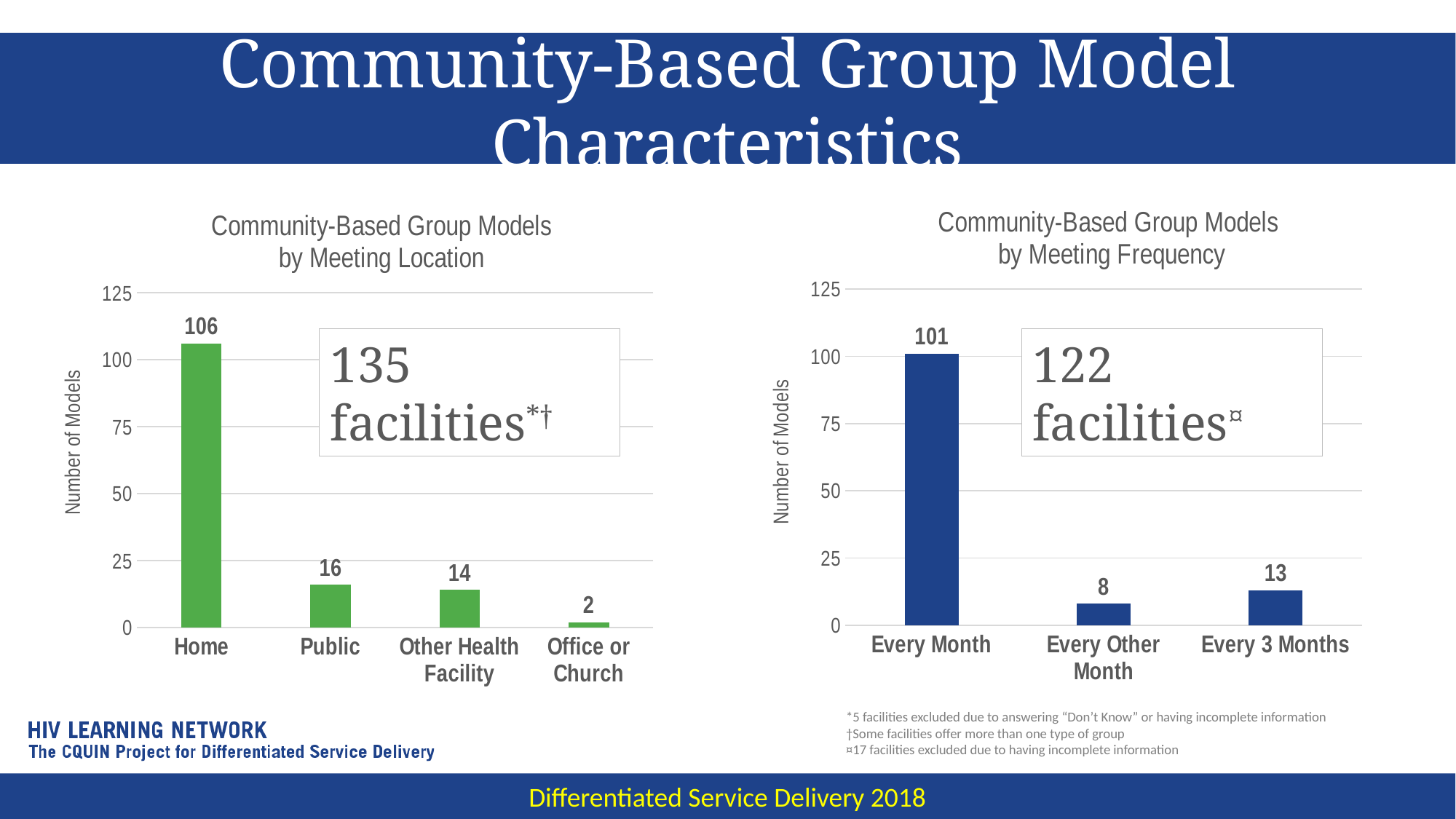
What is the y-axis label on the 'Community-Based Group Models by Meeting Location' chart? Number of Models In the 'Community-Based Group Models by Meeting Frequency' chart, how many models meet Every Month? 101 In the 'Community-Based Group Models by Meeting Frequency' chart, which is larger: Every Other Month or Every 3 Months? Every 3 Months What kind of chart is the 'Community-Based Group Models by Meeting Frequency' chart? Bar chart In the 'Community-Based Group Models by Meeting Location' chart, how many meeting location categories are shown? 4 In the 'Community-Based Group Models by Meeting Frequency' chart, what is the value for Every Other Month? 8 In the 'Community-Based Group Models by Meeting Frequency' chart, which meeting frequency has the highest number of models? Every Month In the 'Community-Based Group Models by Meeting Location' chart, what is the difference between the Public and Other Health Facility values? 2 In the 'Community-Based Group Models by Meeting Location' chart, how many models meet at Home? 106 In the 'Community-Based Group Models by Meeting Location' chart, which meeting location has the lowest number of models? Office or Church In the 'Community-Based Group Models by Meeting Frequency' chart, what is the difference between Every Month and Every 3 Months? 88 In the 'Community-Based Group Models by Meeting Location' chart, what is the value for Office or Church? 2